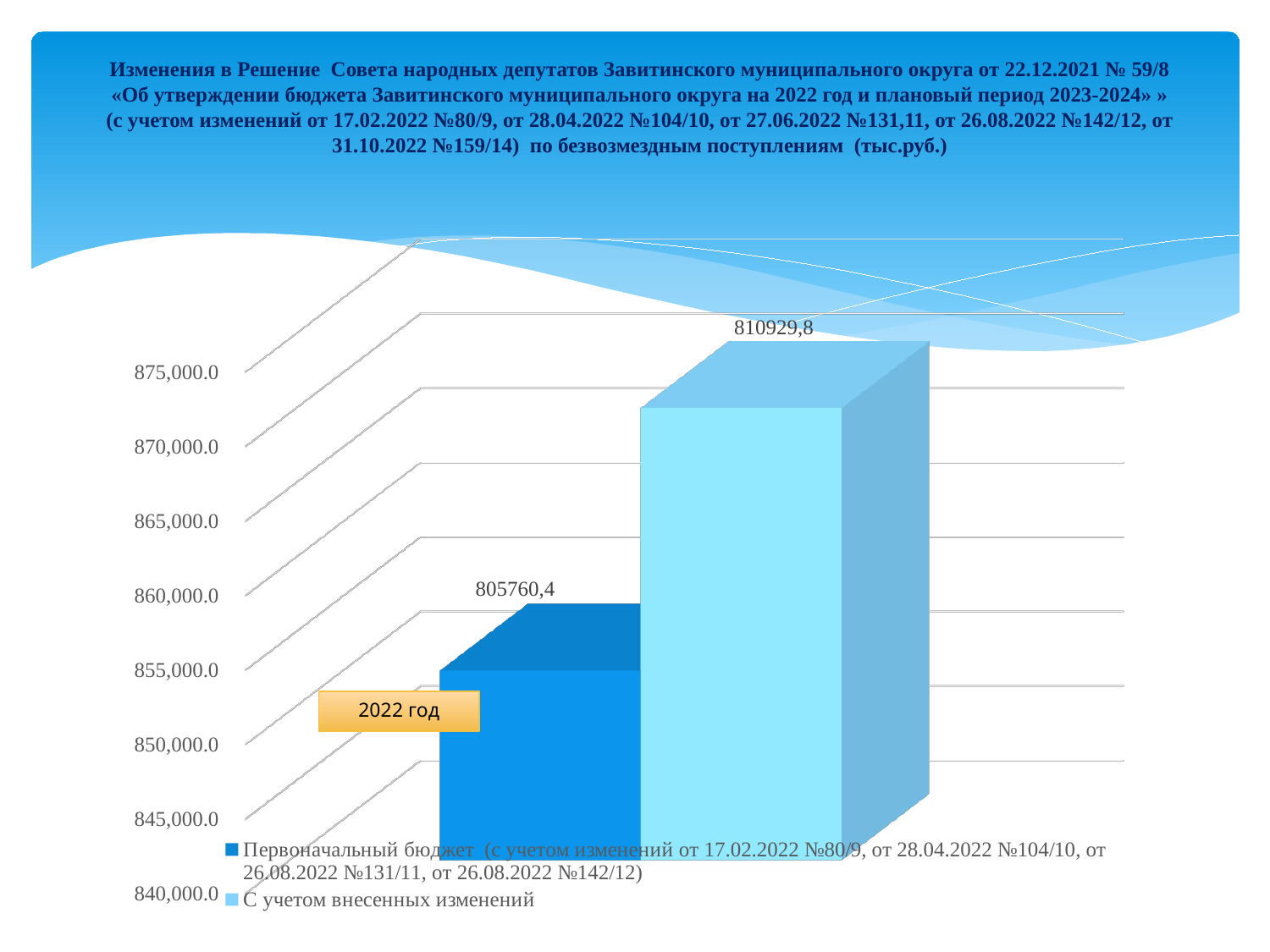
Which series has the highest value on the chart? С учетом внесенных изменений Which series has the higher value: 'Первоначальный бюджет' or 'С учетом внесенных изменений'? С учетом внесенных изменений What category label is shown on the chart? 2022 год What is the difference between the 'С учетом внесенных изменений' value and the 'Первоначальный бюджет' value? 5169,4 How many bars are plotted on the chart? 2 What is the value of the 'С учетом внесенных изменений' bar? 810929,8 What kind of chart is shown on the slide? Bar chart Which series has the lowest value on the chart? Первоначальный бюджет What is the highest value shown on the vertical axis? 875,000.0 How many series does the legend list? 2 What is the value of the 'Первоначальный бюджет' bar? 805760,4